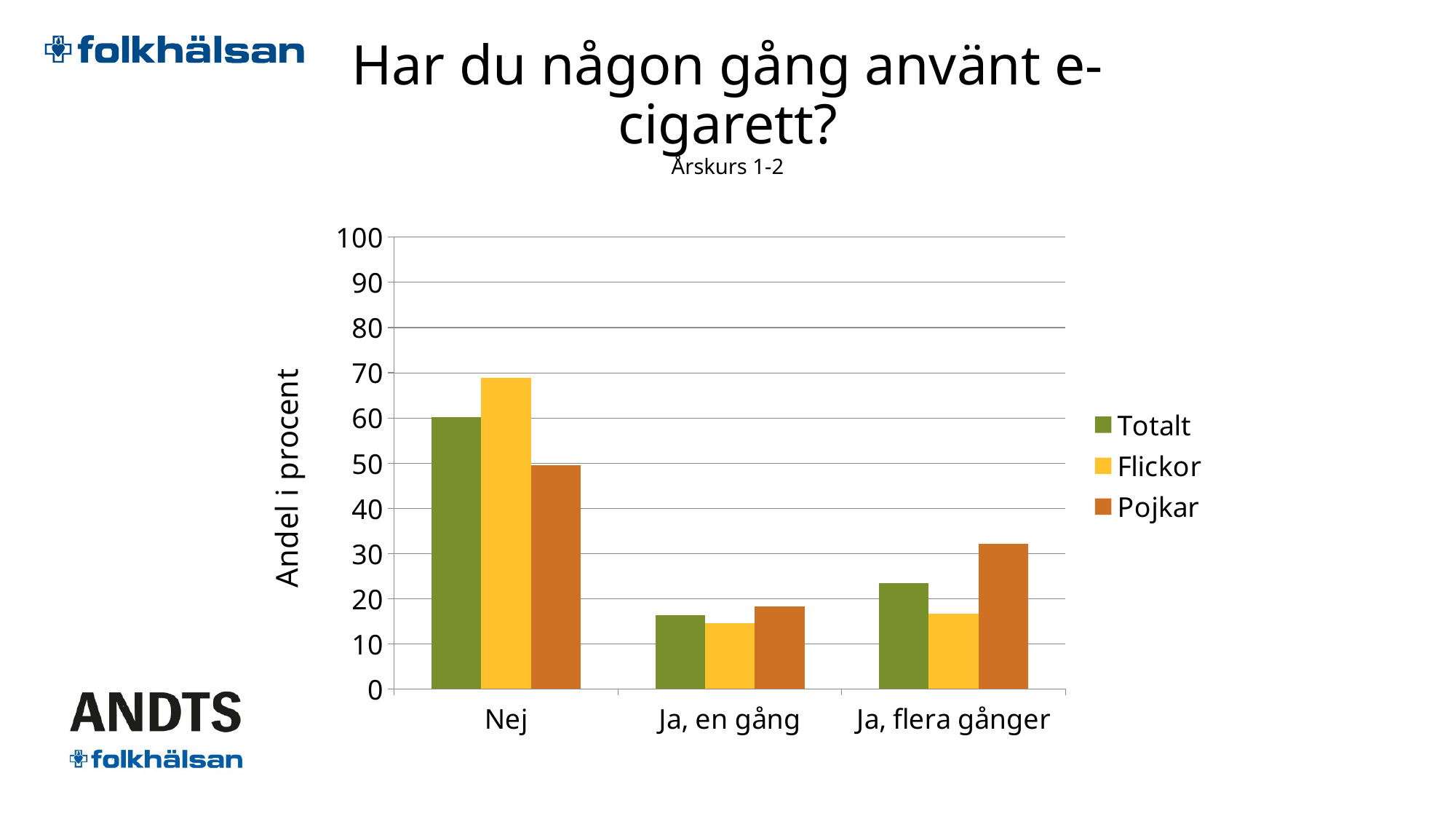
What is the label of the vertical axis? Andel i procent Which series is shown in yellow according to the legend? Flickor How many series does the legend list? 3 Is the value for Flickor in the category Nej greater or less than 60? greater For the category Nej, which is larger: Flickor or Pojkar? Flickor Is the value for Pojkar in the category Ja, flera gånger greater or less than 40? less What kind of chart is shown on the slide? bar chart Is the value for Totalt in the category Ja, en gång greater or less than 20? less How many answer categories are shown on the x axis? 3 Which series has the lowest value in the category Ja, en gång? Flickor For the category Ja, flera gånger, which is larger: Pojkar or Flickor? Pojkar Which category has the highest value for Flickor? Nej